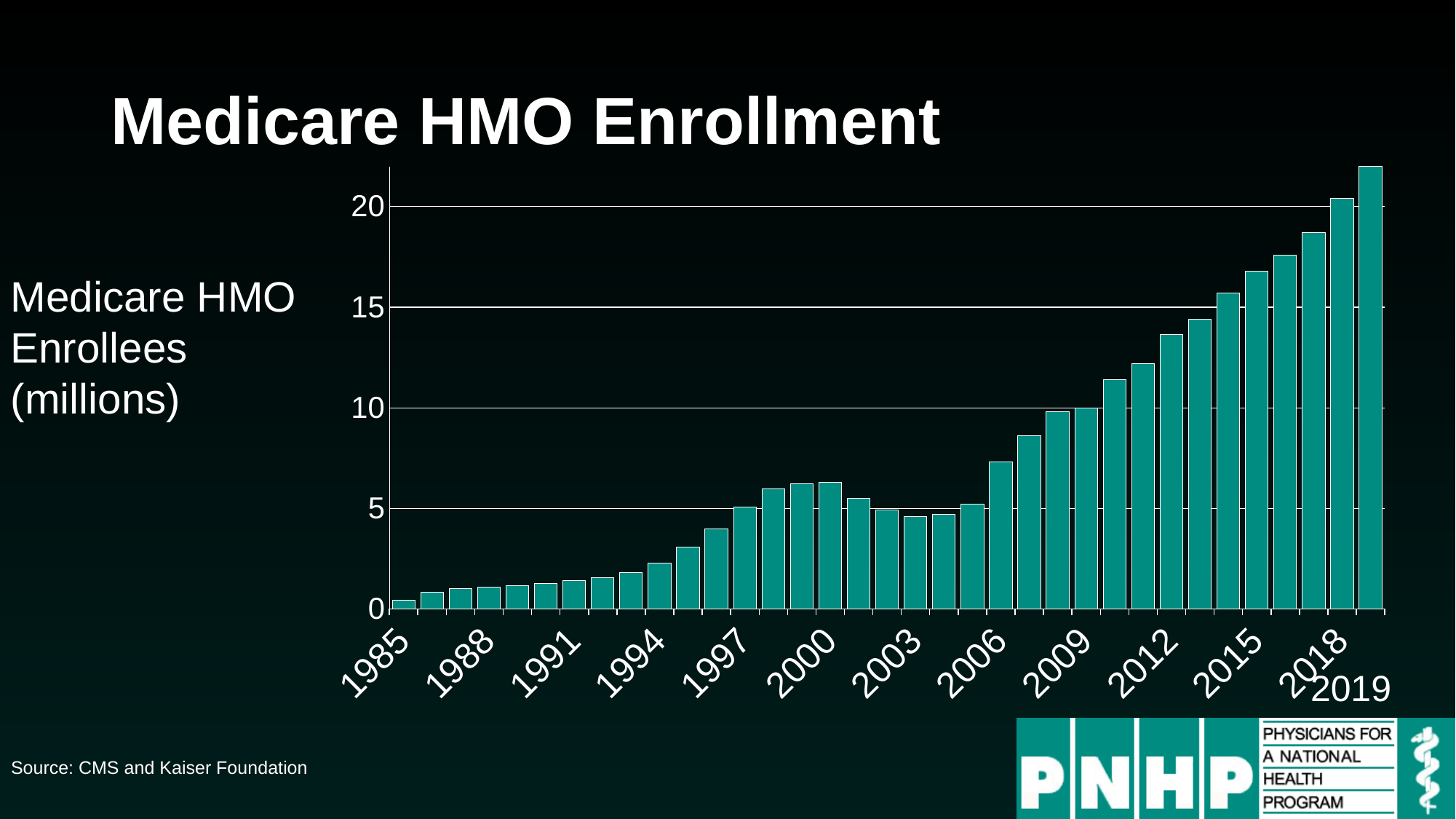
What kind of chart is shown on the slide? bar chart Is the value for 2012 greater or less than 15? less Is the value for 2017 greater or less than 20? less Is the value for 2019 greater or less than 20? greater Which year has the highest Medicare HMO enrollment? 2019 Do the values generally rise or fall from 1985 to 2019? rise Which year has the lowest Medicare HMO enrollment? 1985 What is the title of the chart? Medicare HMO Enrollment Which year has the larger value, 2000 or 2003? 2000